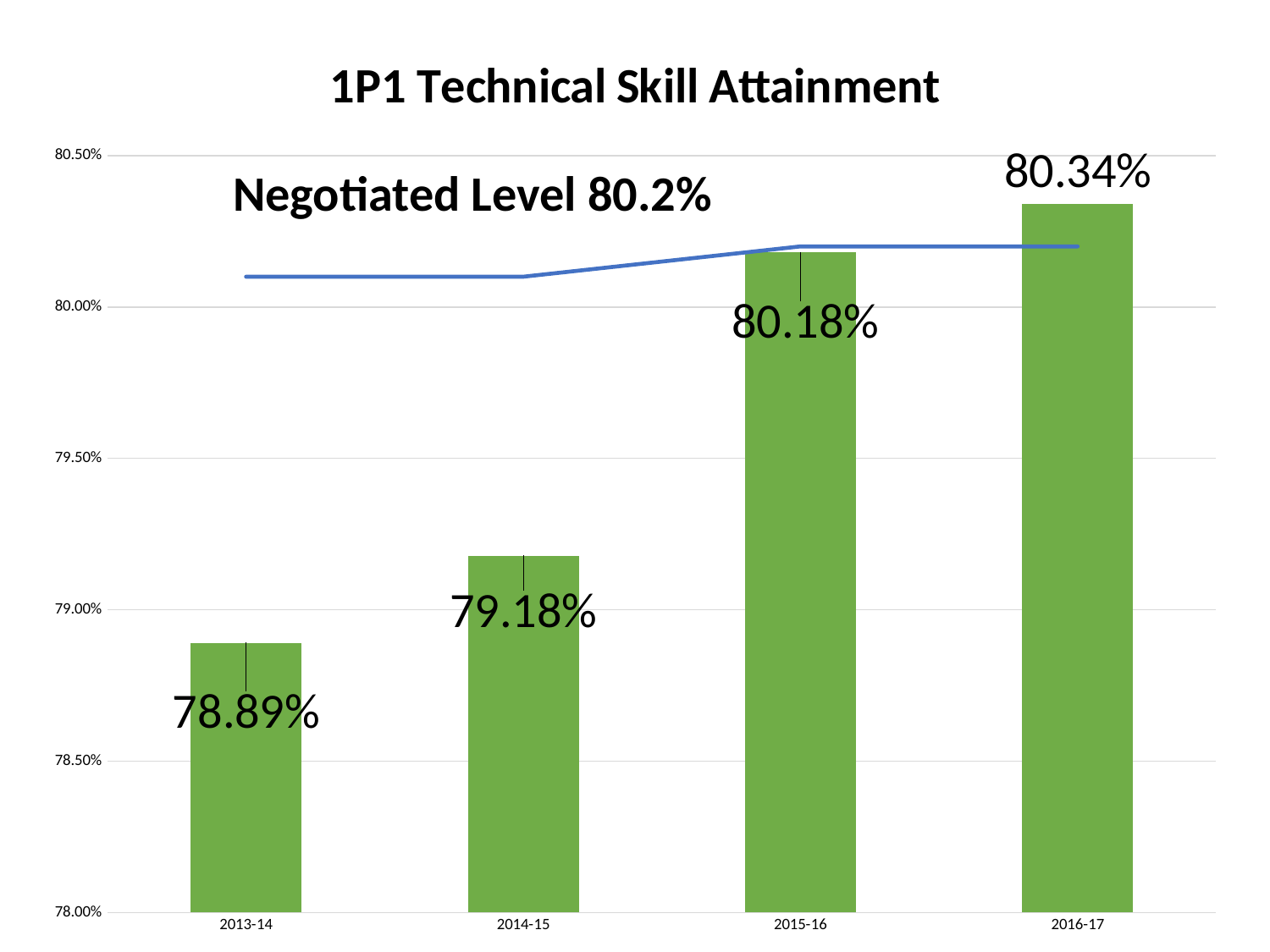
Is the value for 2014-15 greater or less than 79.50%? less What is the value for 2014-15? 79.18% How many years are shown on the x axis? 4 What is the value for 2013-14? 78.89% Which year has the lowest value? 2013-14 What is the difference between the values for 2016-17 and 2013-14? 1.45% What is the value for 2015-16? 80.18% What kind of chart is this? combination bar and line chart What is the value for 2016-17? 80.34% Which year has the highest value? 2016-17 Do the bar values rise or fall from 2013-14 to 2016-17? rise Which is larger, the value for 2014-15 or the value for 2015-16? 2015-16